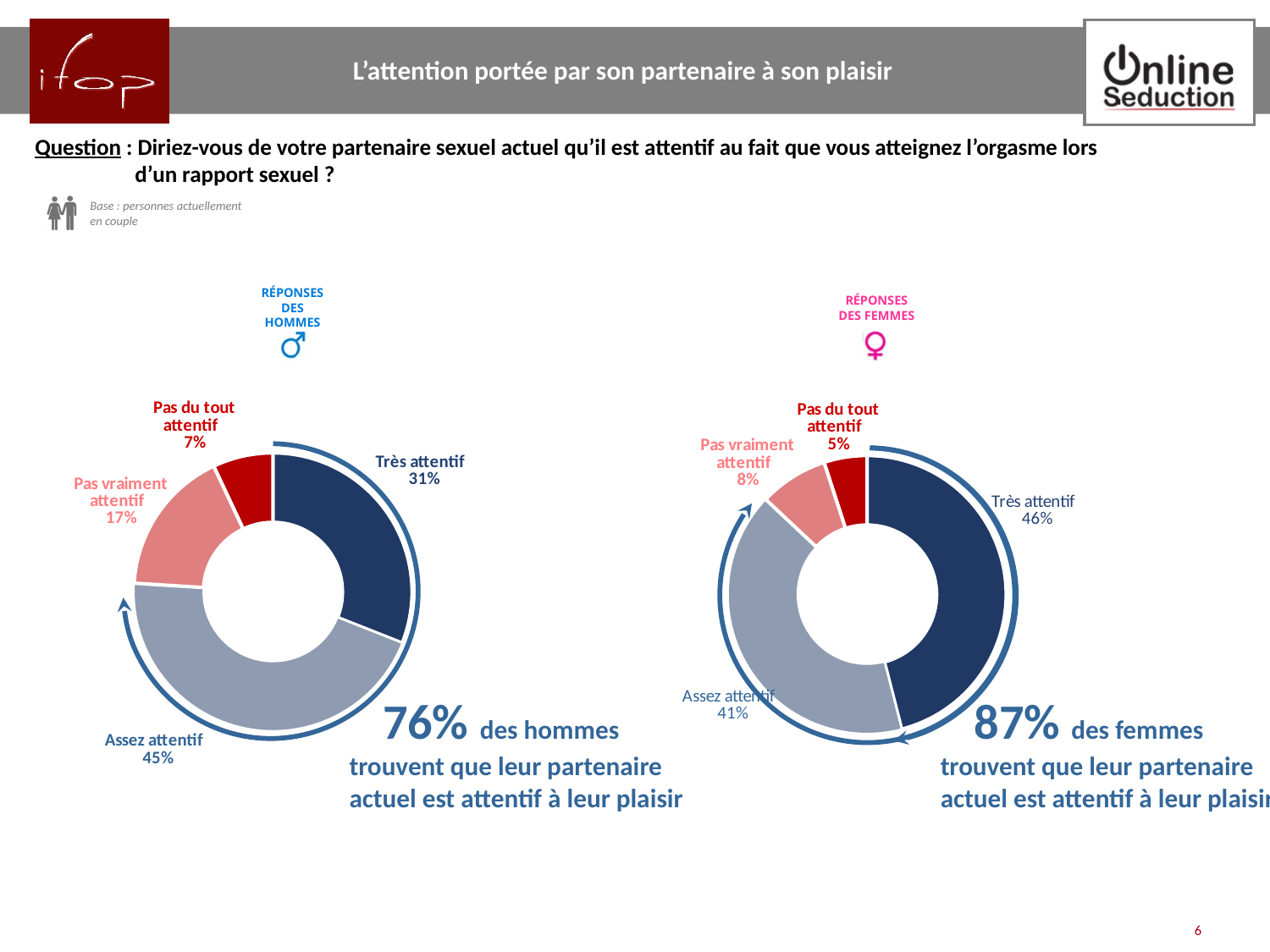
In the right chart (Réponses des femmes), which response category has the largest share? Très attentif In the left chart (Réponses des hommes), what is the combined share of "Très attentif" and "Assez attentif"? 76% How many response categories are shown in the left chart (Réponses des hommes)? 4 What colour is used for the "Pas du tout attentif" slice in both charts? Red What is the difference between the "Très attentif" share in the women's chart and the "Très attentif" share in the men's chart? 15 percentage points In the right chart (Réponses des femmes), what percentage of women answered "Pas vraiment attentif"? 8% In the left chart (Réponses des hommes), what percentage of men answered "Très attentif"? 31% In the right chart (Réponses des femmes), which response category has the smallest share? Pas du tout attentif In the left chart (Réponses des hommes), what is the difference between the "Assez attentif" and "Pas vraiment attentif" shares? 28 percentage points In the left chart (Réponses des hommes), which response category has the largest share? Assez attentif Which is larger: the "Pas du tout attentif" share for men or for women? Men (7%) What type of chart is used to show the men's responses? Donut (pie) chart